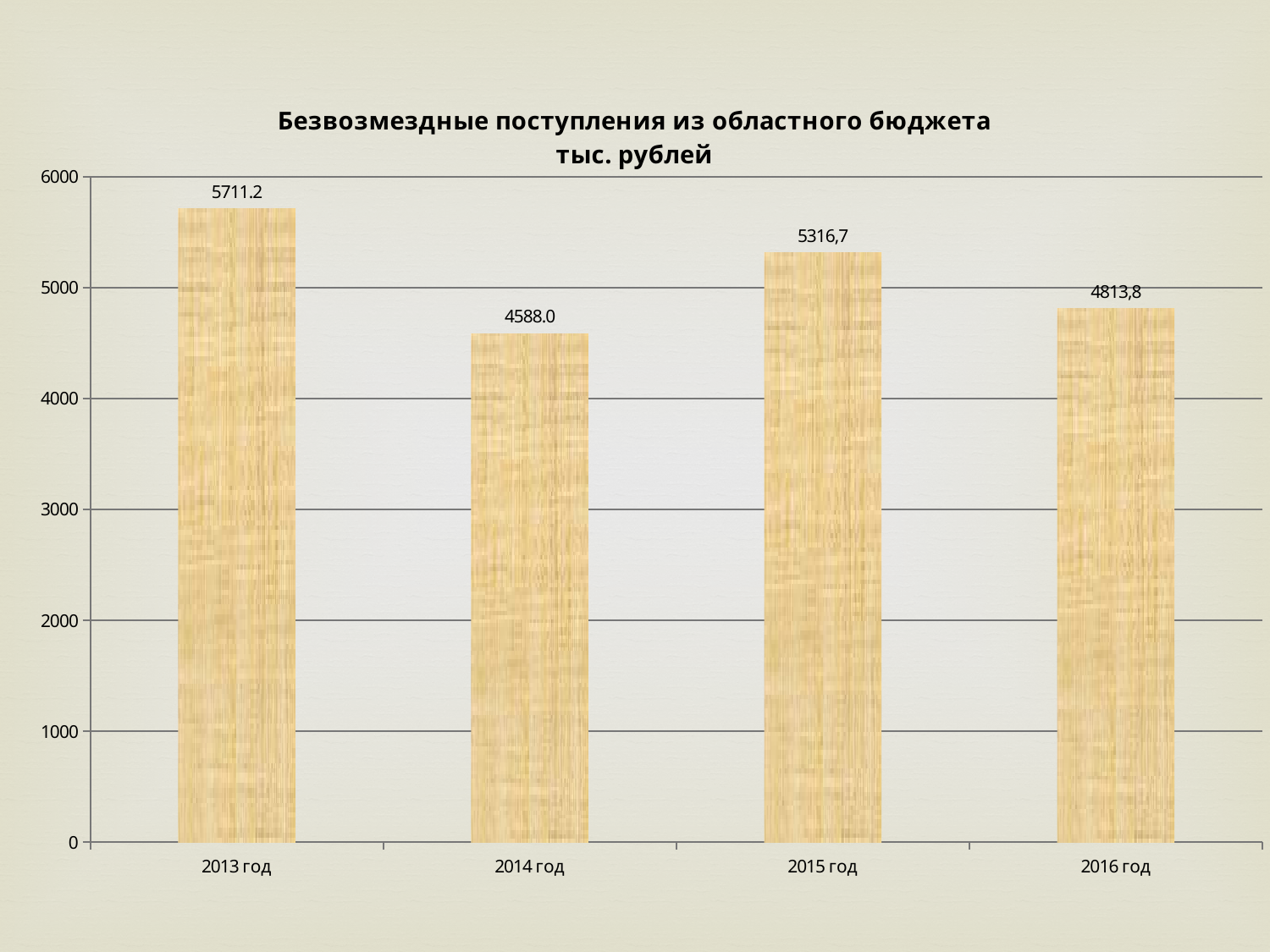
How many years are shown on the x axis? 4 What is the value for 2014 год? 4588.0 What is the title of the chart? Безвозмездные поступления из областного бюджета тыс. рублей Which year has the highest value? 2013 год Which year has the lowest value? 2014 год What is the difference between the values for 2013 год and 2014 год? 1123.2 Is the value for 2016 год greater or less than 5000? less What is the value for 2013 год? 5711.2 What is the value for 2015 год? 5316,7 What kind of chart is shown on the slide? bar chart Which is larger, the value for 2015 год or the value for 2016 год? 2015 год What is the value for 2016 год? 4813,8